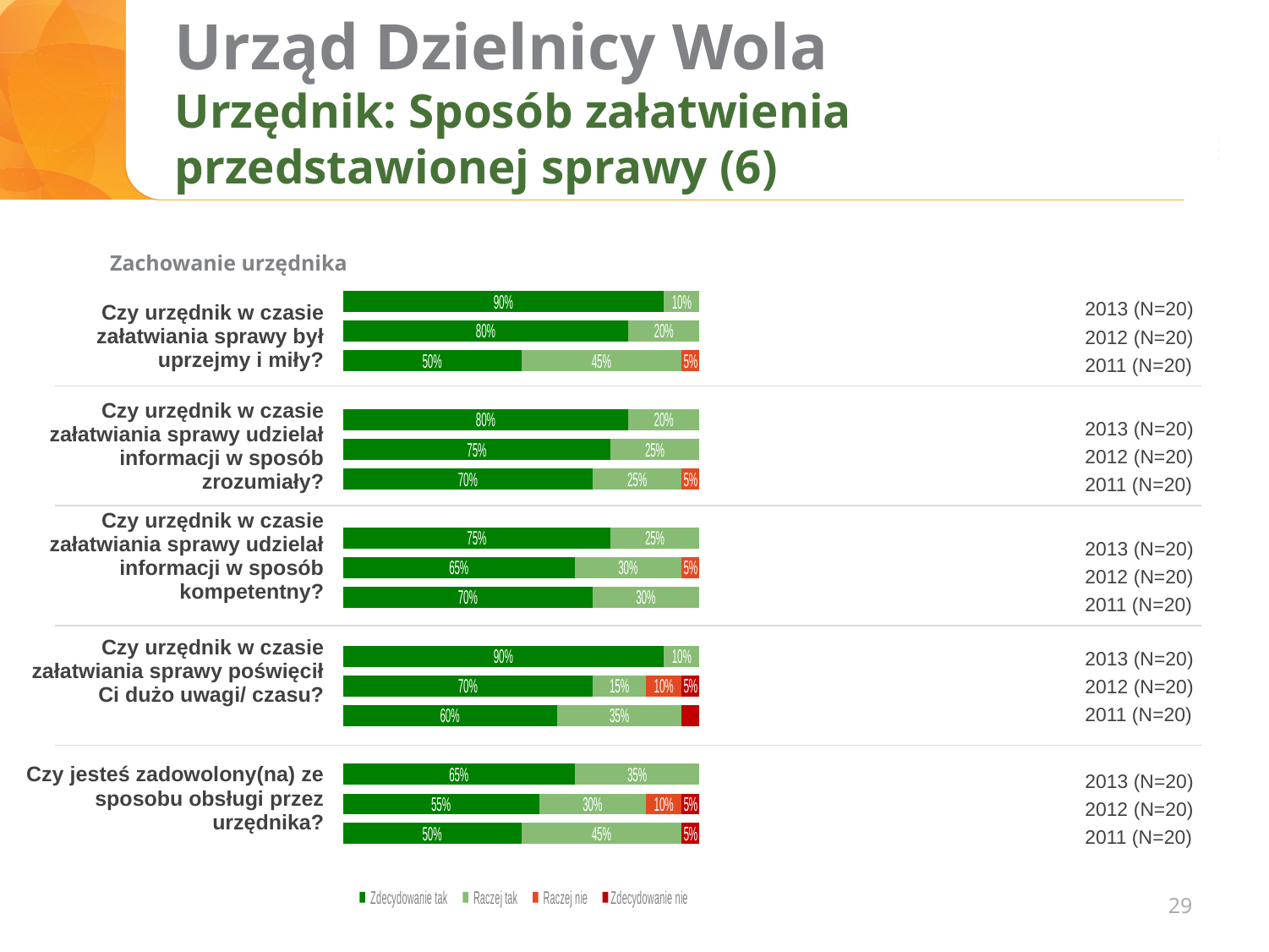
How many bars (years) are shown in the chart for "Czy urzędnik w czasie załatwiania sprawy udzielał informacji w sposób kompetentny?"? 3 In the chart for "Czy jesteś zadowolony(na) ze sposobu obsługi przez urzędnika?", which is larger: the "Zdecydowanie tak" value for 2013 or for 2012? 2013 (N=20) What is the name of the legend entry shown in dark green? Zdecydowanie tak In the chart for "Czy jesteś zadowolony(na) ze sposobu obsługi przez urzędnika?", what is the "Raczej nie" value for 2012 (N=20)? 10% In the chart for "Czy urzędnik w czasie załatwiania sprawy był uprzejmy i miły?", what is the "Zdecydowanie tak" value for 2013 (N=20)? 90% In the chart for "Czy urzędnik w czasie załatwiania sprawy był uprzejmy i miły?", what is the "Raczej tak" value for 2011 (N=20)? 45% How many series does the legend at the bottom of the slide list? 4 In the chart for "Czy urzędnik w czasie załatwiania sprawy poświęcił Ci dużo uwagi/ czasu?", what is the difference between the "Zdecydowanie tak" values for 2013 and 2011? 30% In the chart for "Czy urzędnik w czasie załatwiania sprawy był uprzejmy i miły?", does the "Zdecydowanie tak" value rise or fall from 2011 to 2013? Rise What kind of chart is used on this slide? Stacked bar chart In the chart for "Czy urzędnik w czasie załatwiania sprawy udzielał informacji w sposób kompetentny?", which year has the lowest "Zdecydowanie tak" value? 2012 (N=20) In the chart for "Czy urzędnik w czasie załatwiania sprawy udzielał informacji w sposób zrozumiały?", which year has the highest "Zdecydowanie tak" value? 2013 (N=20)